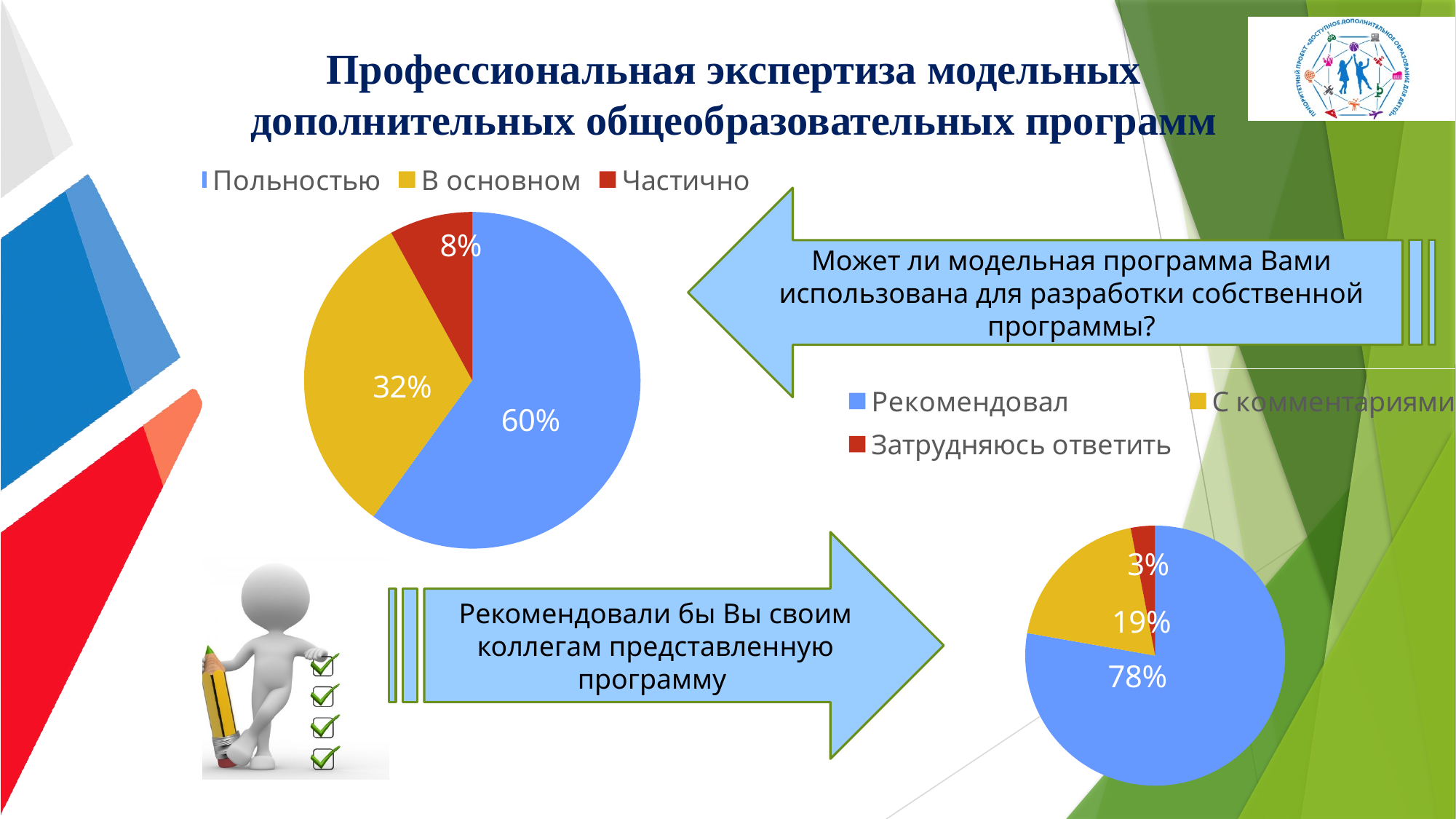
On the bottom-right pie chart, what percentage is shown for 'Рекомендовал'? 78% What type of chart is the left chart on the slide? Pie chart On the bottom-right pie chart, what percentage is shown for 'Затрудняюсь ответить'? 3% On the left pie chart, what percentage is shown for 'В основном'? 32% On the left pie chart, which category has the smallest slice? Частично On the bottom-right pie chart, which category has the smallest slice? Затрудняюсь ответить On the left pie chart, what percentage is shown for 'Частично'? 8% On the bottom-right pie chart, what percentage is shown for 'С комментариями'? 19% On the left pie chart, which category has the largest slice? Польностью How many slices does the bottom-right pie chart have? 3 On the left pie chart, what is the difference in percentage points between 'Польностью' and 'В основном'? 28 On the left pie chart, what share is labelled for the 'Польностью' slice? 60%